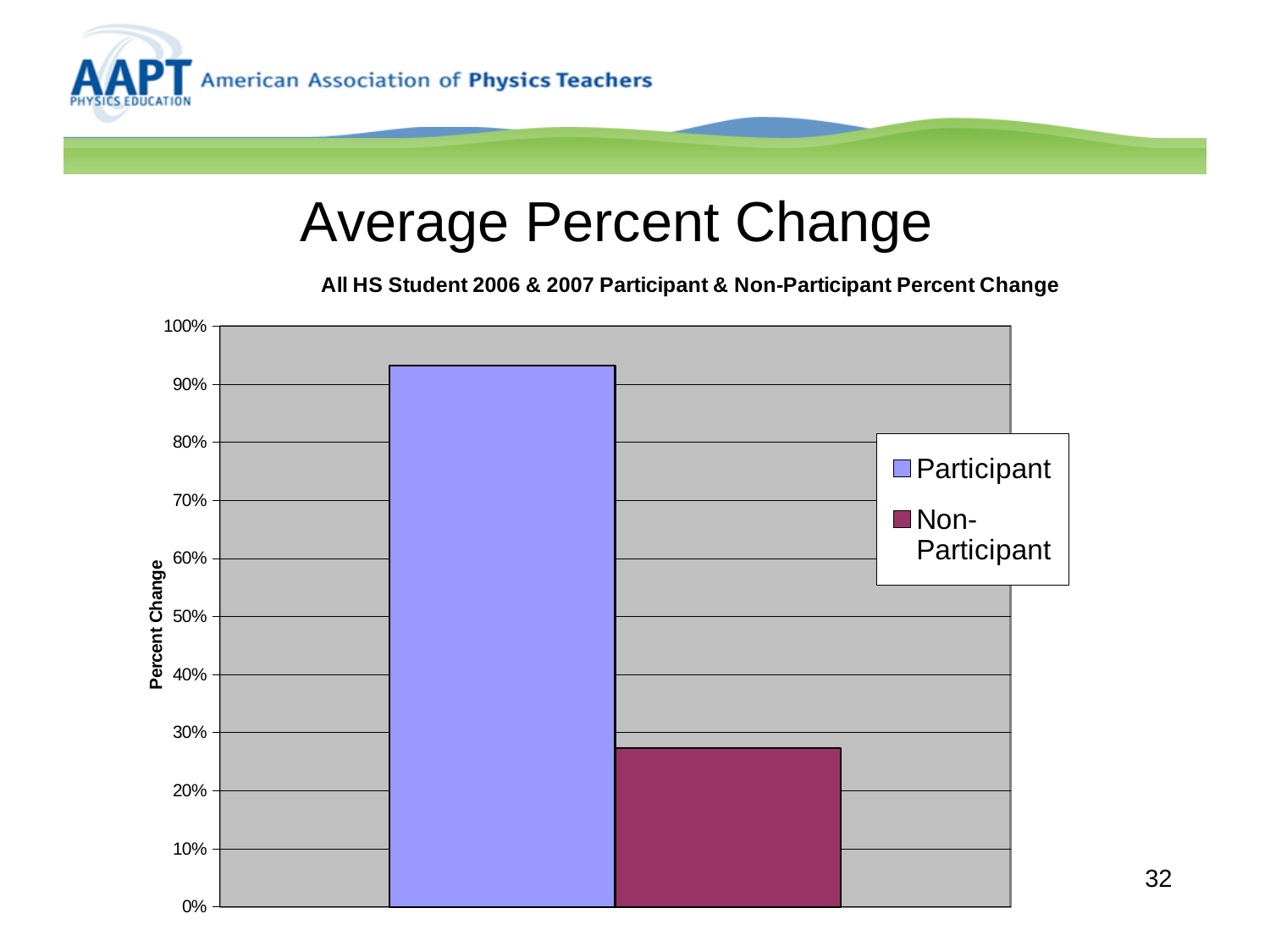
How many bars are plotted in the chart? 2 How many series does the legend list? 2 What is the title of the chart? All HS Student 2006 & 2007 Participant & Non-Participant Percent Change What is the maximum value shown on the vertical axis? 100% Which series has the higher percent change, Participant or Non-Participant? Participant What kind of chart is shown on the slide? bar chart Which series has the lowest percent change? Non-Participant What is the label of the vertical axis? Percent Change Is the value for Non-Participant greater or less than 20%? greater Is the value for Non-Participant greater or less than 30%? less Is the value for Participant greater or less than 90%? greater Which series has the highest percent change? Participant